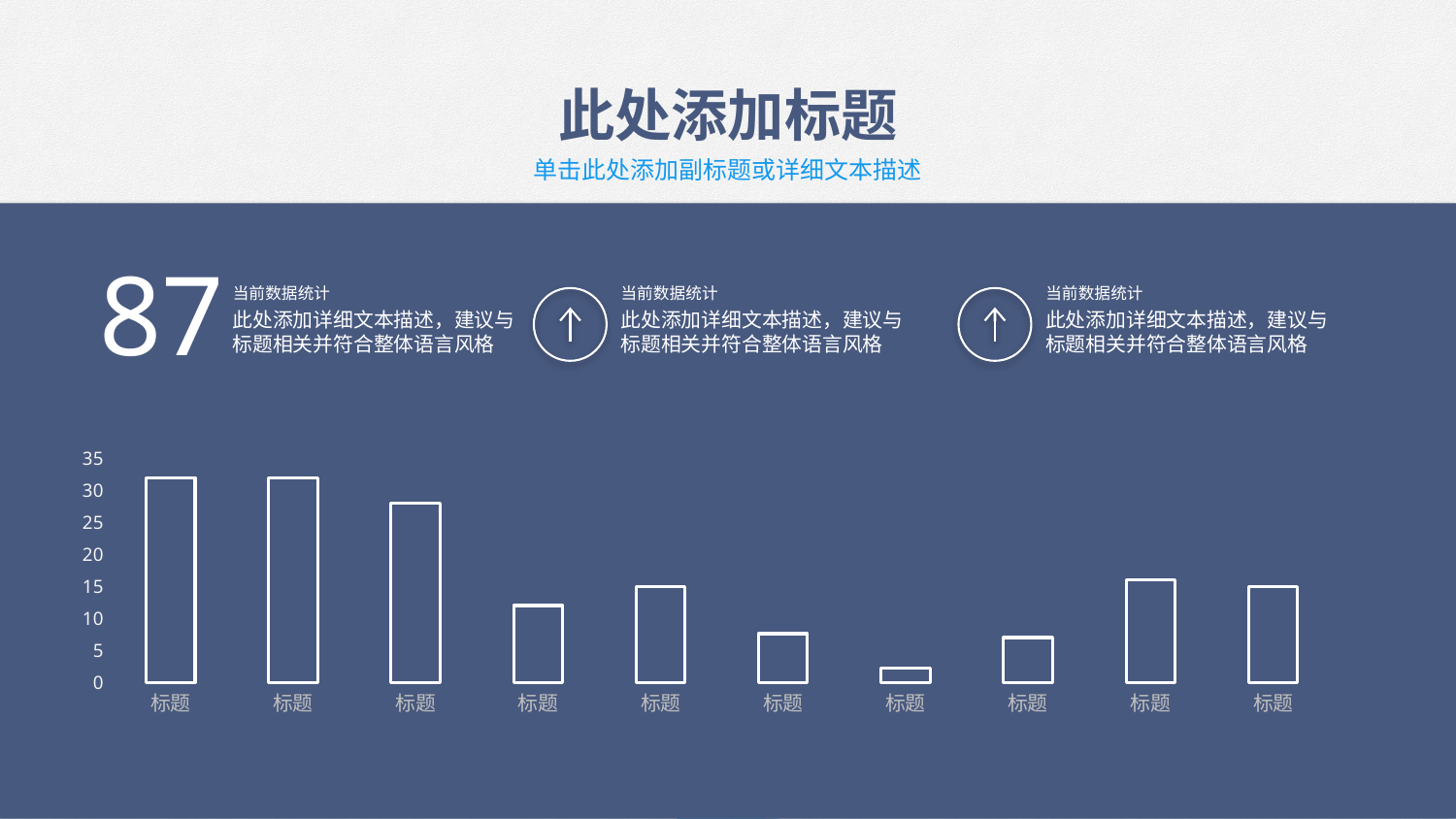
How many bars does the chart contain? 10 Is the value of the fourth bar greater or less than 20? less What label is shown under each bar on the horizontal axis? 标题 Is the value of the third bar greater or less than 20? greater Is the value of the seventh bar greater or less than 5? less Which is larger, the third bar or the fourth bar? the third bar Which is larger, the seventh bar or the ninth bar? the ninth bar Which bar is the lowest in the chart? the seventh bar What kind of chart is shown on the slide? bar chart What is the highest value shown on the vertical axis? 35